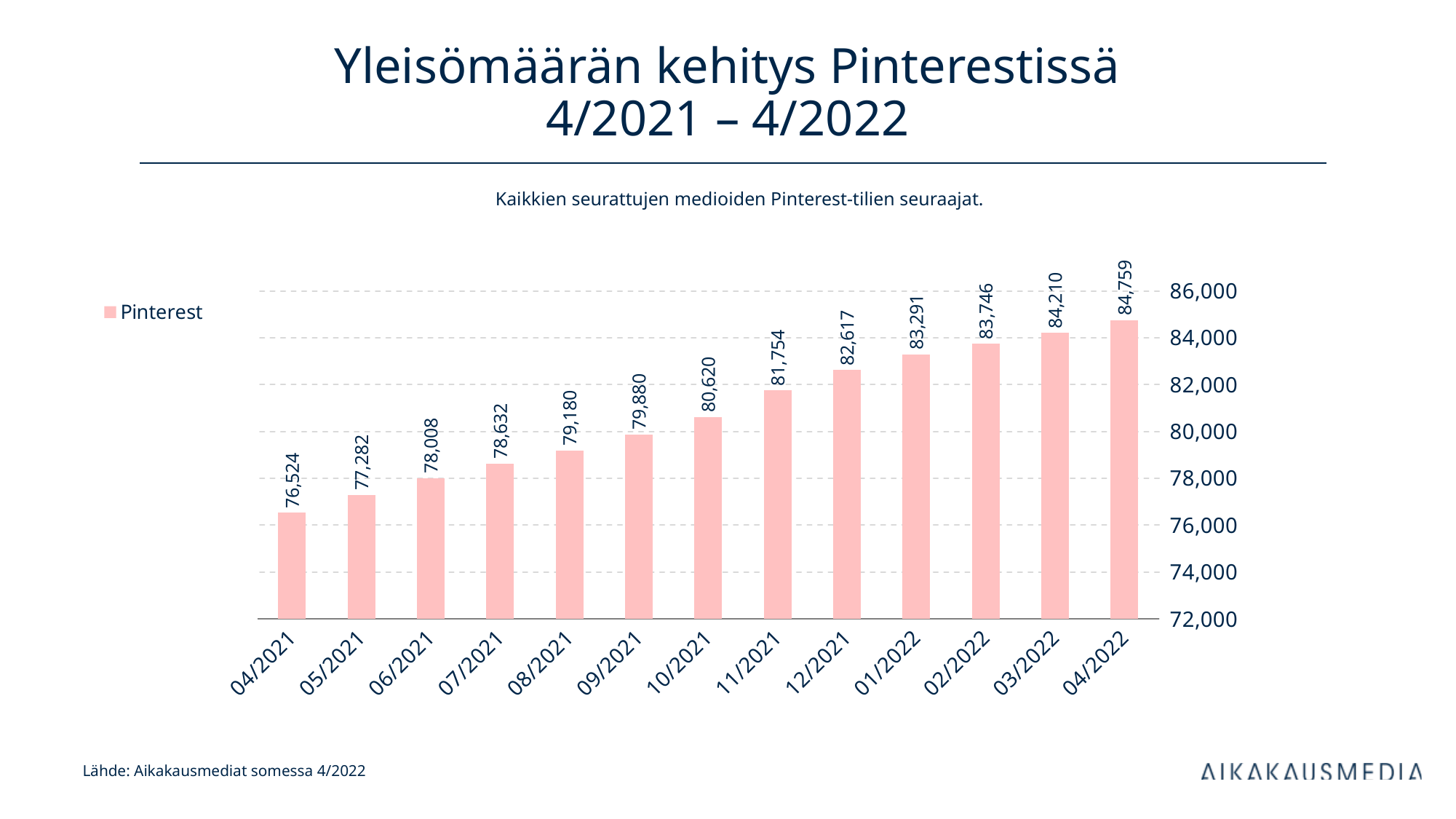
Which month has the lowest value? 04/2021 What is the difference between the values for 04/2022 and 04/2021? 8,235 Which is larger, the value for 08/2021 or the value for 09/2021? 09/2021 What is the value for 04/2021? 76,524 What is the value for 01/2022? 83,291 Which month has the highest value? 04/2022 What is the value for 10/2021? 80,620 Do the values rise or fall from 04/2021 to 04/2022? rise What kind of chart is shown on the slide? bar chart Is the value for 07/2021 greater or less than 80,000? less How many months are shown on the x axis? 13 What is the difference between the values for 12/2021 and 11/2021? 863